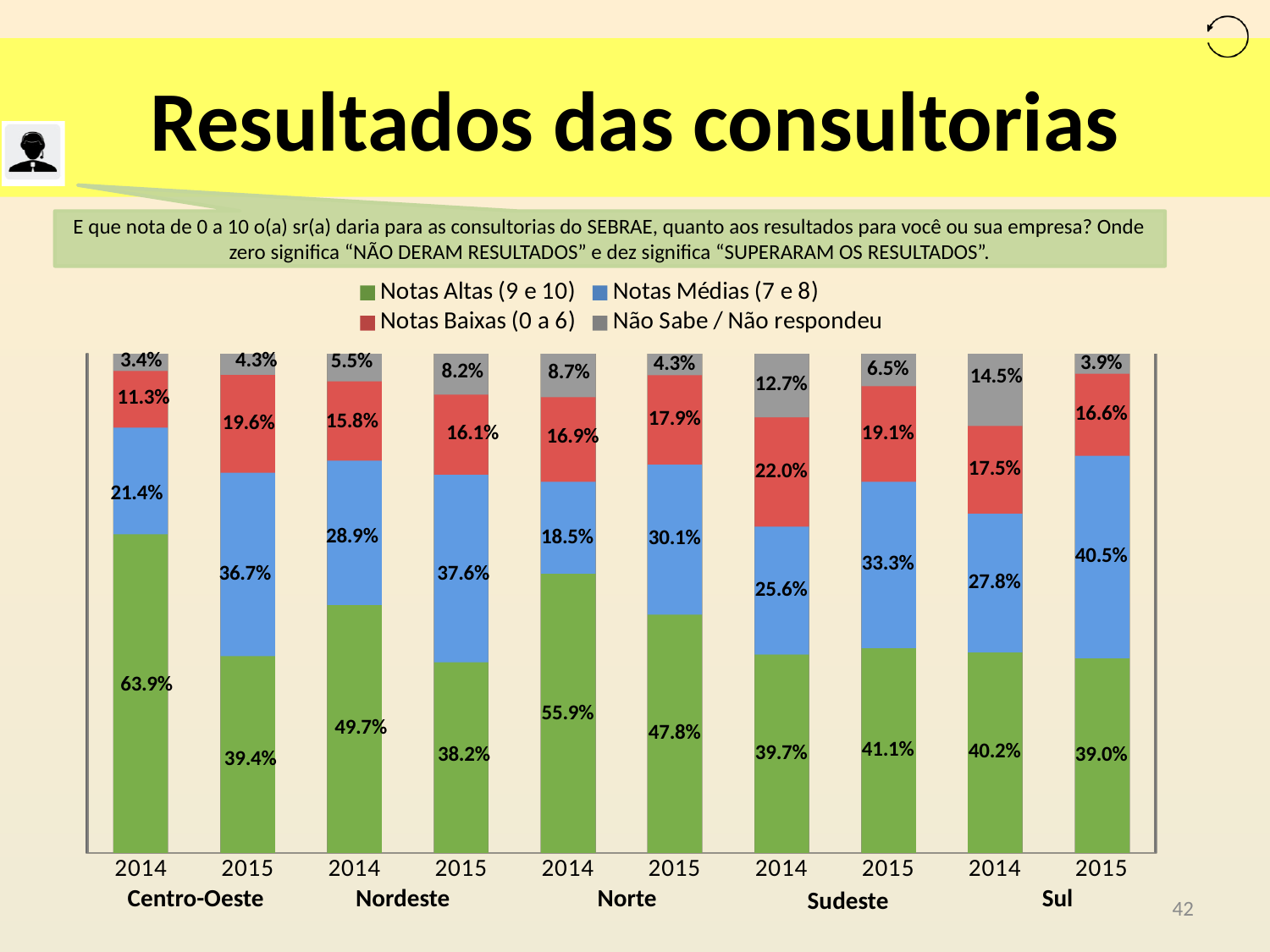
Which bar has the lowest value for Notas Altas (9 e 10)? Nordeste 2015 What is the difference in Notas Altas (9 e 10) between Centro-Oeste 2014 and Centro-Oeste 2015? 24.5 percentage points What is the total of the stacked bar for Sul 2015? 100.0% What is the value of Notas Altas (9 e 10) for Centro-Oeste in 2014? 63.9% Which bar has the highest value for Notas Altas (9 e 10)? Centro-Oeste 2014 What is the value of Não Sabe / Não respondeu for Sudeste in 2014? 12.7% What kind of chart is shown on the slide? Stacked bar chart Which bar has the highest value for Não Sabe / Não respondeu? Sul 2014 What is the value of Notas Médias (7 e 8) for Sul in 2015? 40.5% Which is larger: Notas Baixas (0 a 6) for Sudeste 2014 or for Sudeste 2015? Sudeste 2014 How many bars are shown in the chart? 10 How many series does the legend list? 4